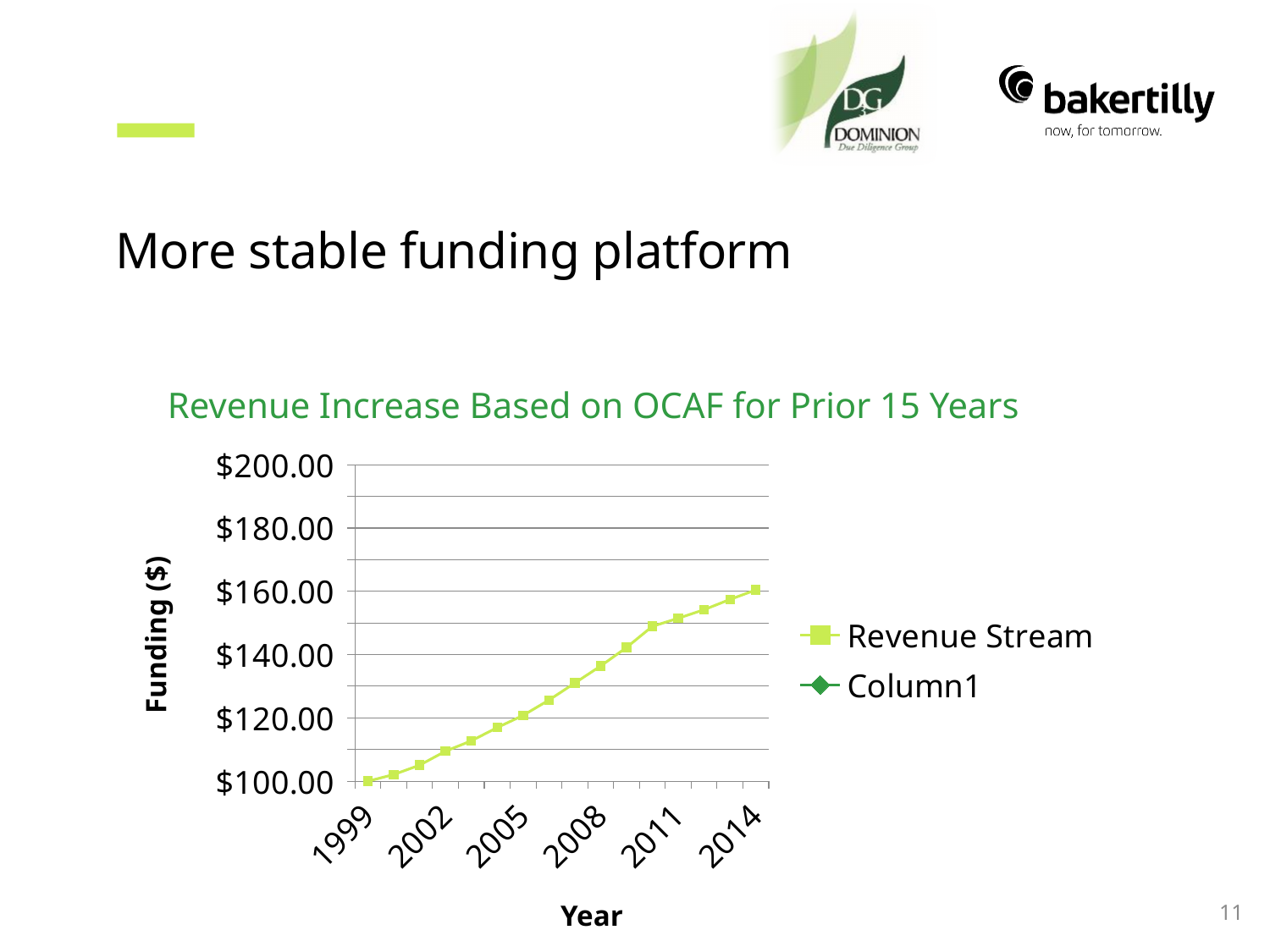
What is the label of the vertical axis? Funding ($) Which year has the highest Revenue Stream value? 2014 Is the Revenue Stream value for 2014 greater or less than $140.00? greater Which year has the larger Revenue Stream value, 2002 or 2011? 2011 Which year has the lowest Revenue Stream value? 1999 Do the Revenue Stream values rise or fall from 1999 to 2014? rise Is the Revenue Stream value for 2005 greater or less than $140.00? less What is the title of the chart? Revenue Increase Based on OCAF for Prior 15 Years How many data points are plotted on the Revenue Stream line? 16 What kind of chart is shown on the slide? line chart What is the Revenue Stream value for 1999? $100.00 How many series does the chart's legend list? 2